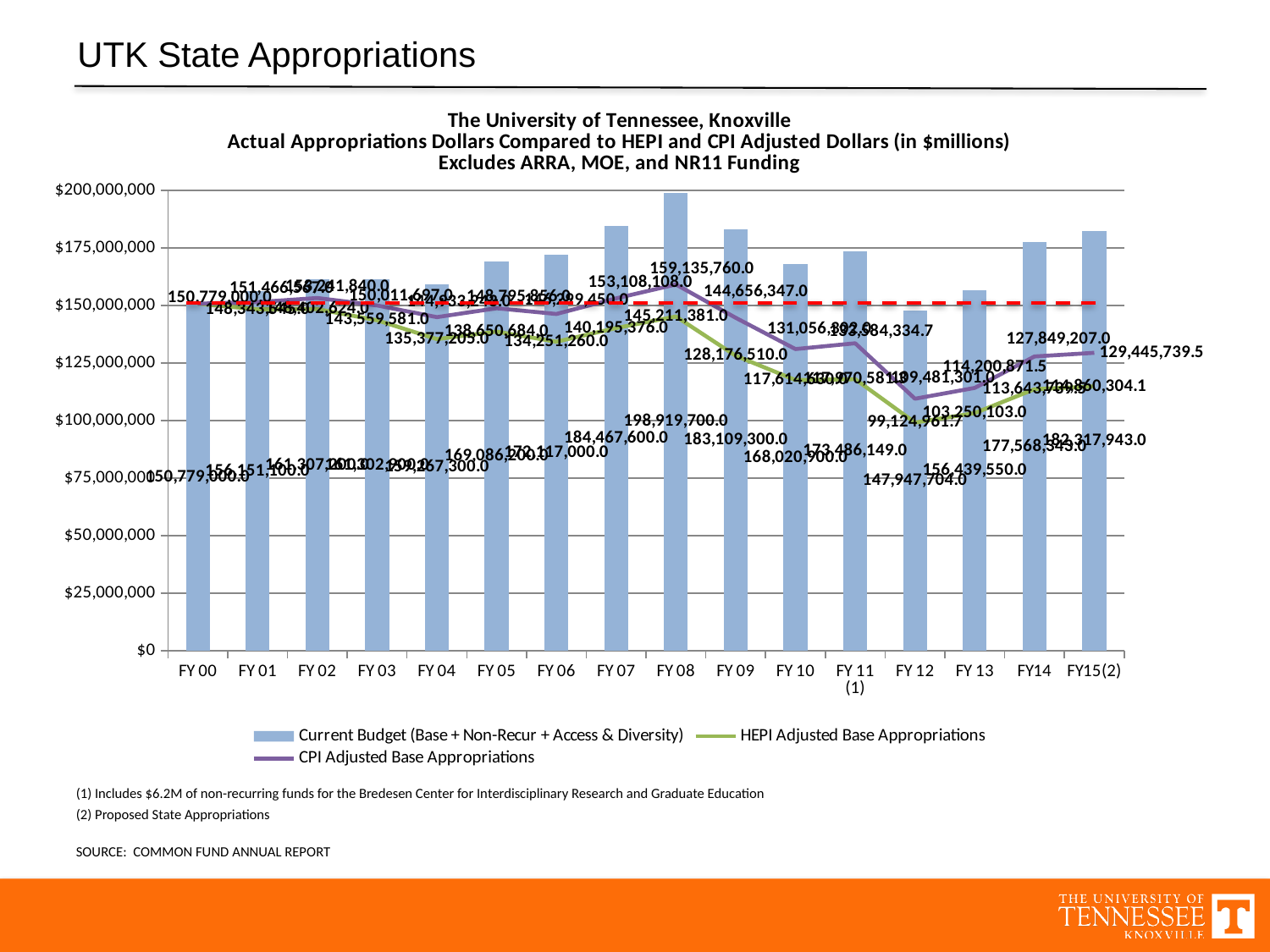
Which fiscal year has the highest Current Budget bar? FY 08 What is the Current Budget value for FY 08? 198,919,700.0 How many series does the legend list? 3 What is the difference between the Current Budget values for FY 08 and FY 07? 14,452,100.0 Which has the larger Current Budget bar, FY 08 or FY 12? FY 08 How many fiscal years are shown along the x axis? 16 Is the Current Budget bar for FY 08 greater or less than $175,000,000? greater Does the HEPI Adjusted Base Appropriations line rise or fall from FY 08 to FY 12? fall What is the Current Budget value for FY 12? 147,947,704.0 What is the CPI Adjusted Base Appropriations value for FY 09? 144,656,347.0 What kind of chart is shown on the slide? bar chart with line series What is the HEPI Adjusted Base Appropriations value for FY 12? 99,124,961.7